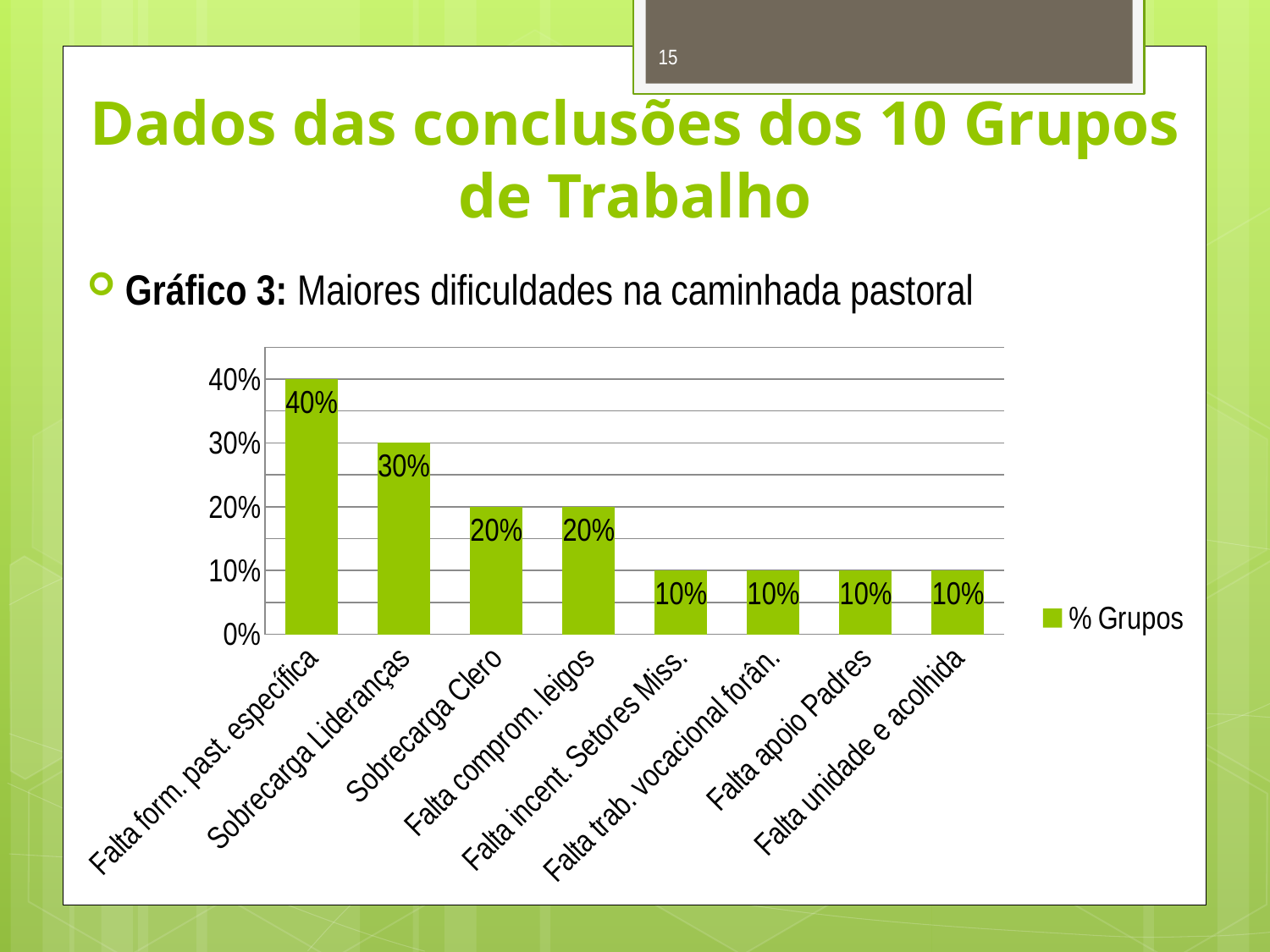
What is the value for Falta form. past. específica? 40% What is the difference between Sobrecarga Lideranças and Falta unidade e acolhida? 20% Which is larger, Sobrecarga Clero or Falta trab. vocacional forân.? Sobrecarga Clero How many categories are shown on the x axis? 8 What is the value for Sobrecarga Clero? 20% What is the value for Falta apoio Padres? 10% What kind of chart is shown? Bar chart What is the value for Sobrecarga Lideranças? 30% What is the name of the series in the legend? % Grupos How many series does the legend list? 1 Which category has the highest value? Falta form. past. específica What is the difference between Falta form. past. específica and Sobrecarga Lideranças? 10%